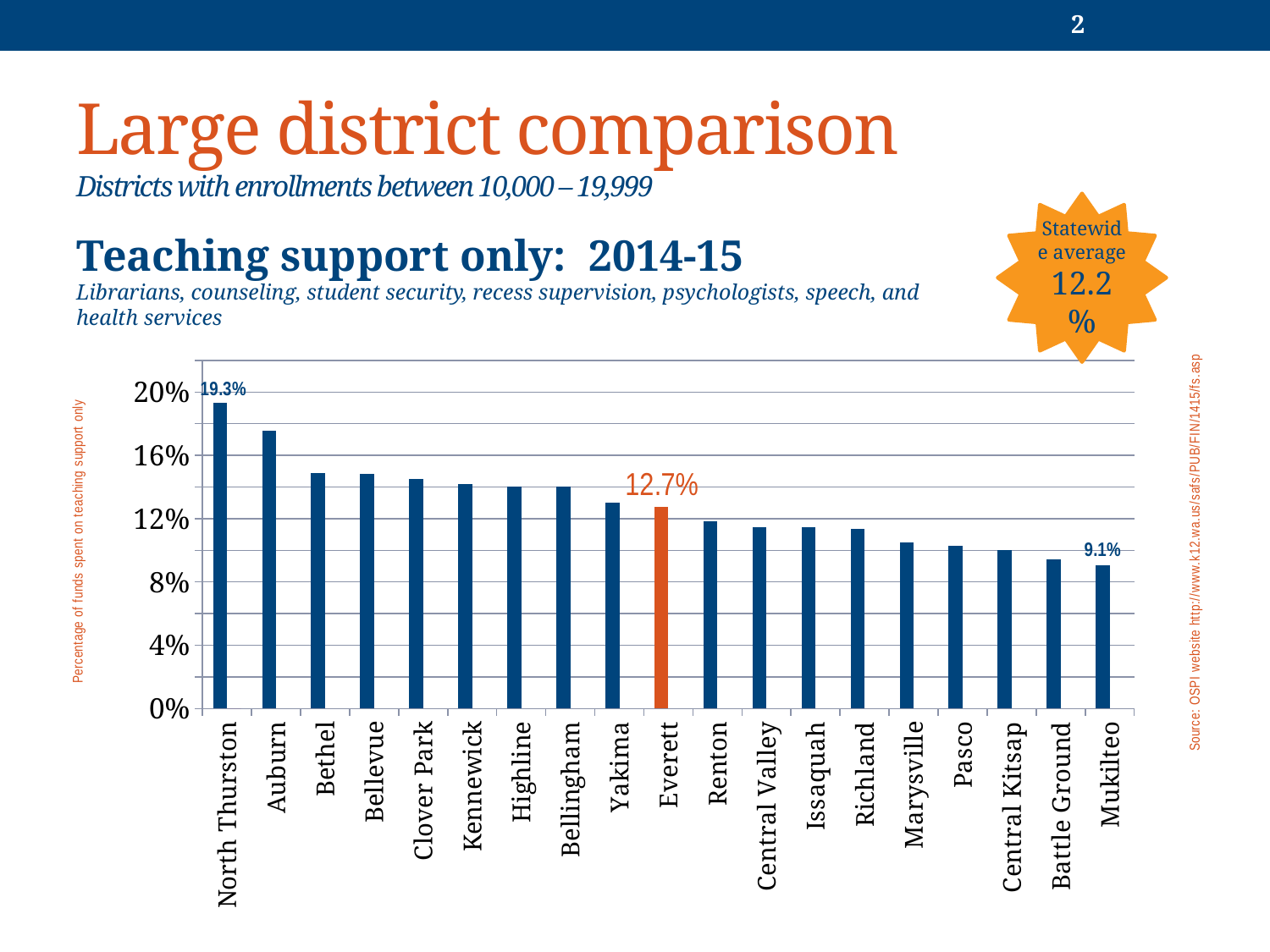
Which district has the lowest percentage of funds spent on teaching support only? Mukilteo Do the values rise or fall from left to right along the x axis? fall What is the difference between the values for North Thurston and Everett? 6.6 percentage points What kind of chart is shown on the slide? bar chart Which district has the highest percentage of funds spent on teaching support only? North Thurston Is the value for Auburn greater or less than 16%? greater What is the value for North Thurston? 19.3% What is the value for Mukilteo? 9.1% Which is larger, the value for Auburn or the value for Bethel? Auburn What is the value for Everett? 12.7% What is the difference between the values for Everett and Mukilteo? 3.6 percentage points How many districts are shown on the chart? 19